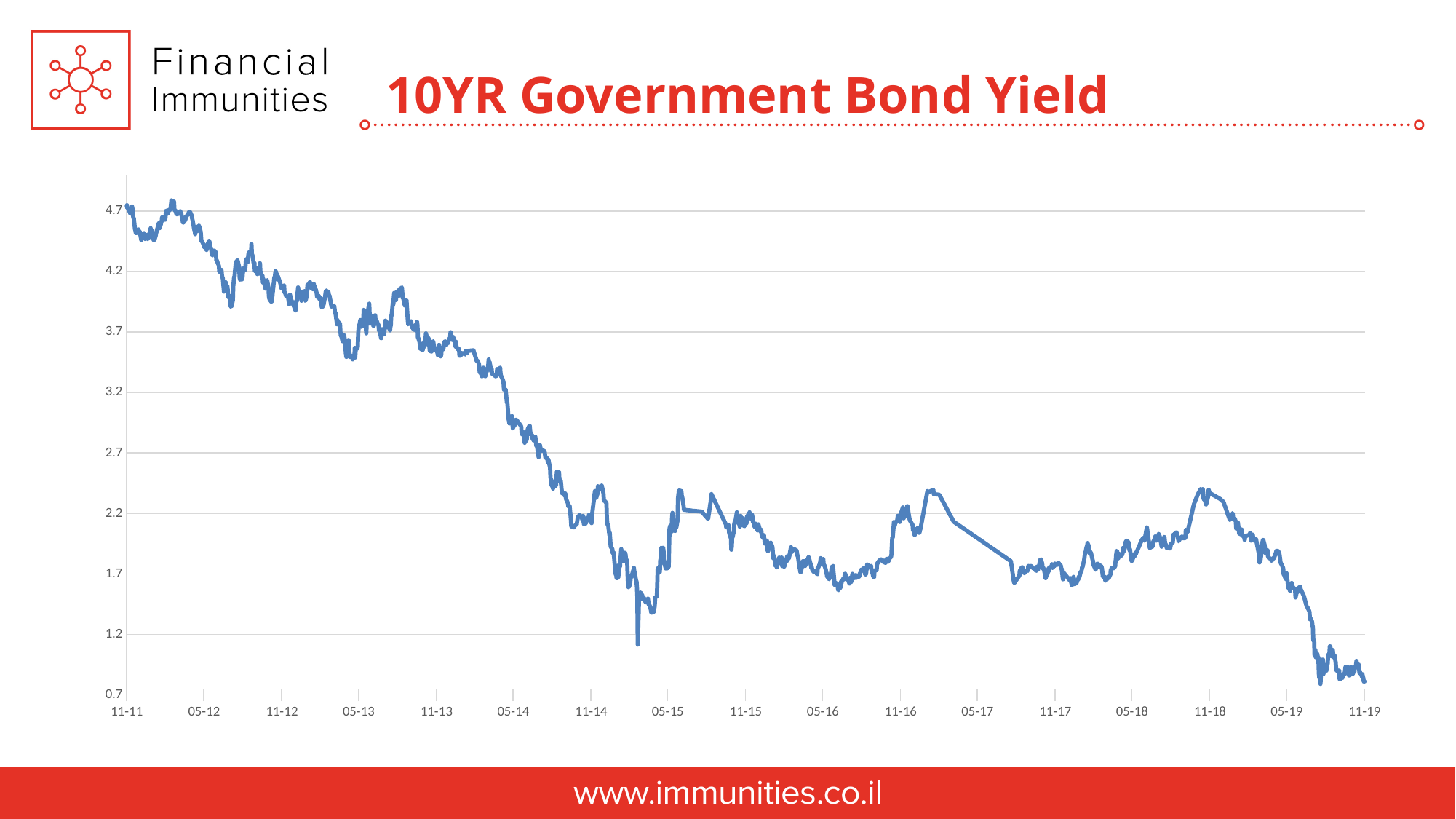
Is the value at 11-19 greater or less than 1.2? less Which is larger, the value at 11-13 or the value at 11-15? 11-13 Is the value at 05-17 greater or less than 2.7? less Is the value at 05-14 greater or less than 2.7? greater Overall, does the bond yield rise or fall from 11-11 to 11-19? fall What kind of chart is shown on the slide? line chart How many date labels are shown on the x axis? 17 What is the title of the chart? 10YR Government Bond Yield Which is larger, the value at 11-11 or the value at 11-19? 11-11